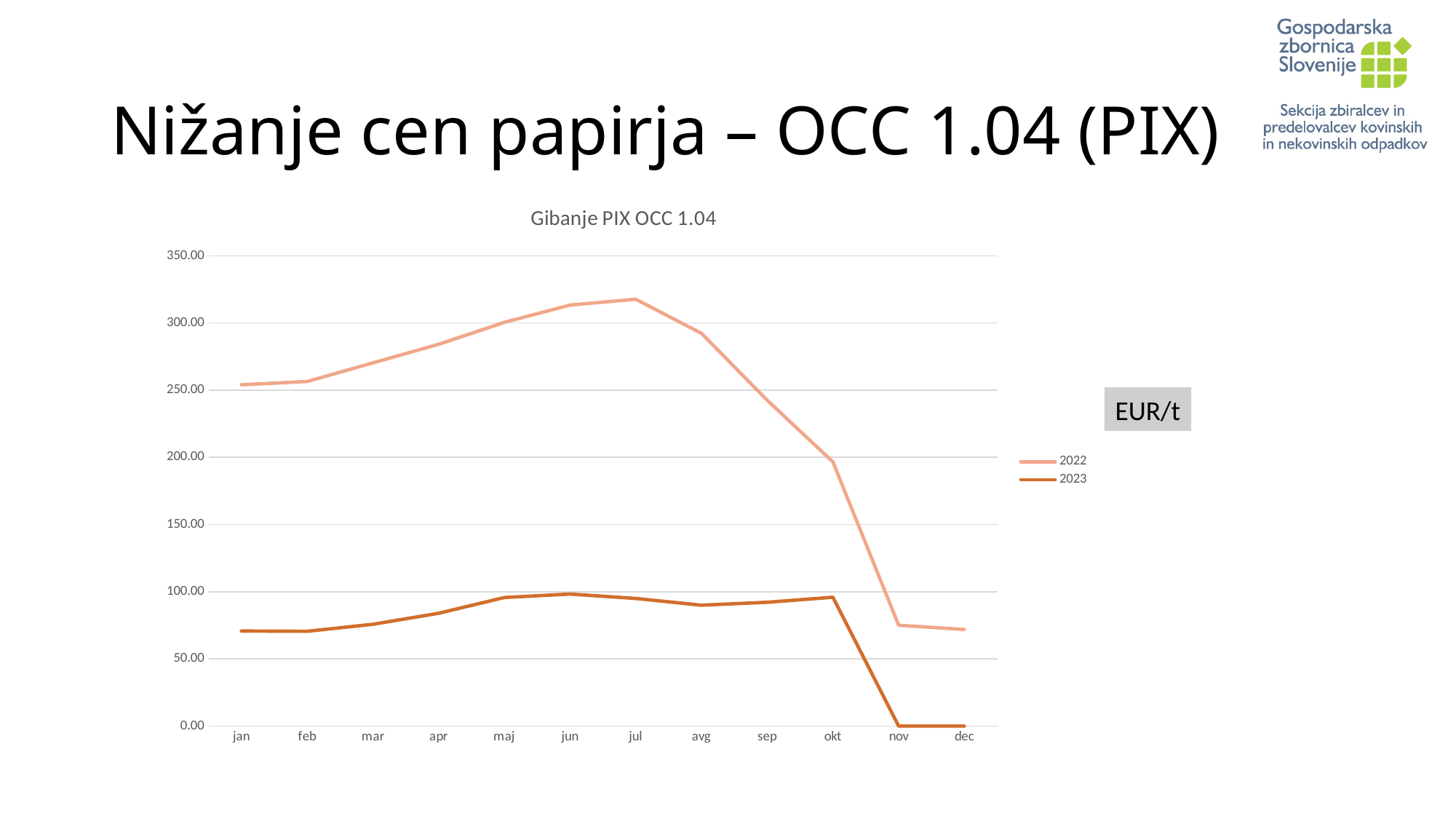
Is the value for 2022 in nov greater or less than 100.00? less Which series has the larger value in jul, 2022 or 2023? 2022 Does the 2022 line rise or fall from jul to dec? fall How many months are shown on the x axis? 12 What is the value for 2023 in nov? 0.00 How many series does the legend list? 2 What is the title of the chart? Gibanje PIX OCC 1.04 What kind of chart is shown on the slide? line chart What is the value for 2023 in dec? 0.00